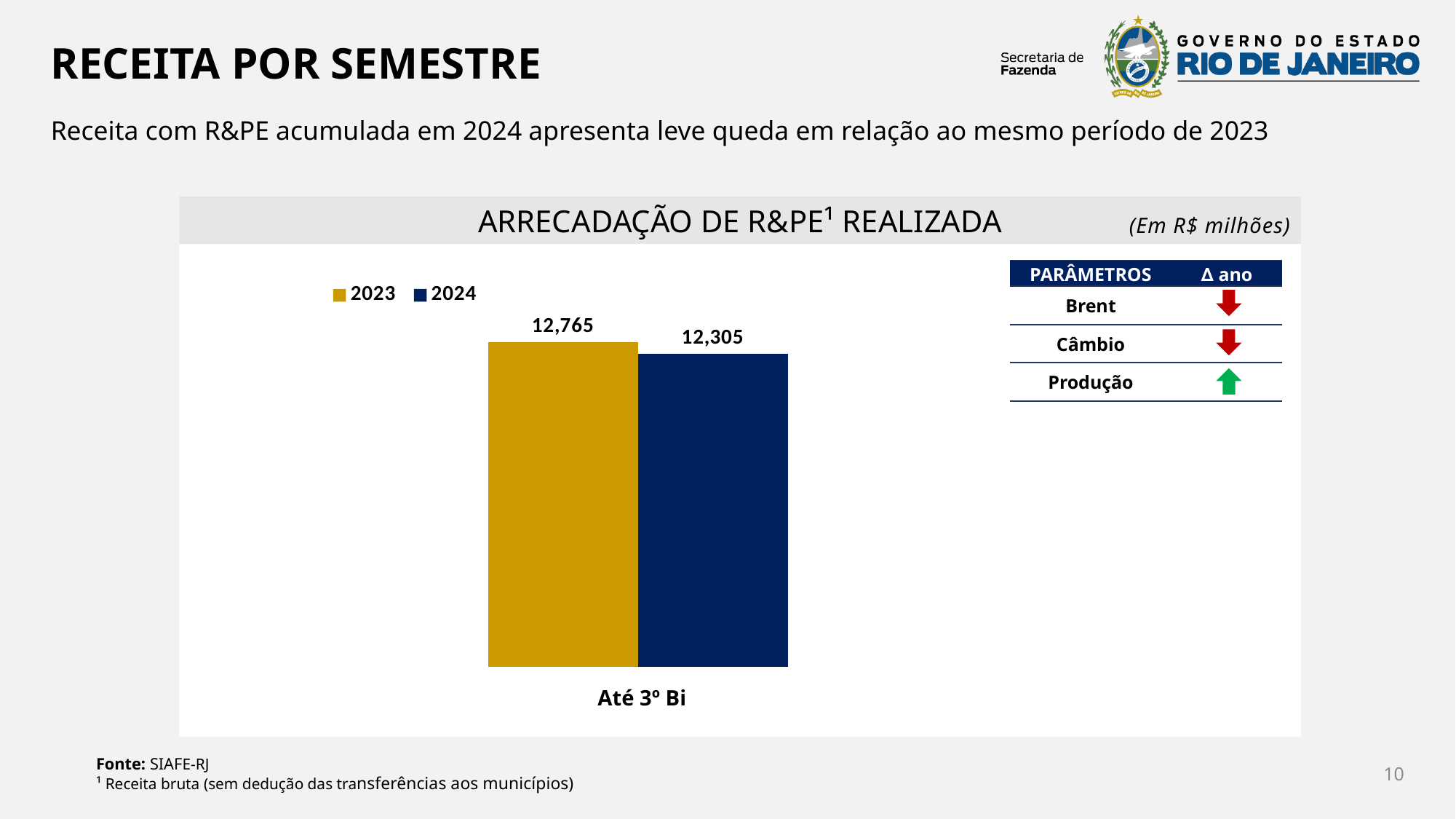
What colour is the bar for the 2024 series? Dark blue What is the title of the chart? ARRECADAÇÃO DE R&PE¹ REALIZADA What is the label of the category on the x axis? Até 3º Bi What is the difference between the 2023 and 2024 values for 'Até 3º Bi'? 460 How many categories are shown on the x axis? 1 Which series has the higher value for 'Até 3º Bi', 2023 or 2024? 2023 How many series does the legend list? 2 What kind of chart is shown on the slide? Bar chart What is the value for 2024 in the 'Até 3º Bi' category? 12,305 What is the value for 2023 in the 'Até 3º Bi' category? 12,765 Which series has the lowest value in the chart? 2024